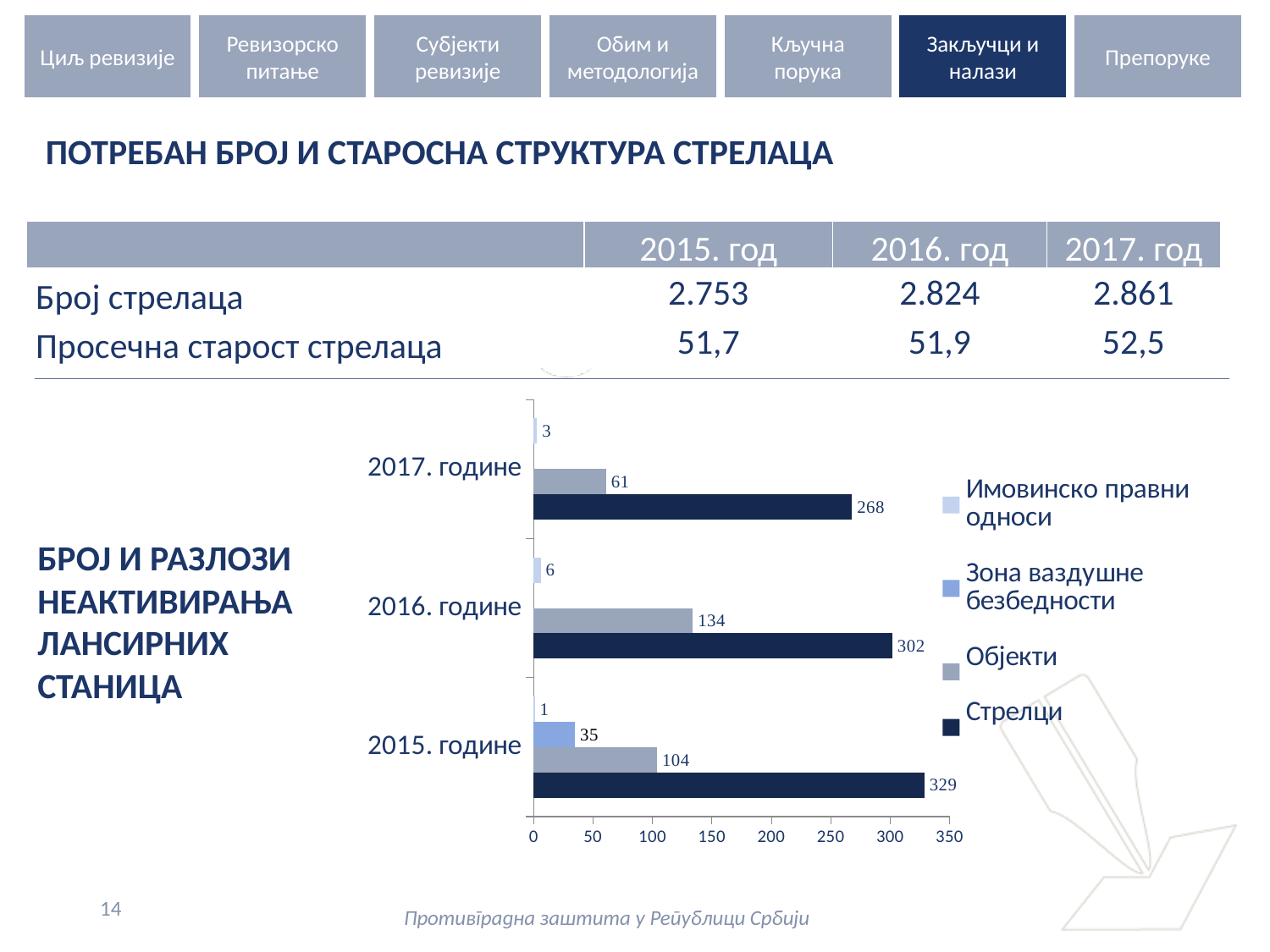
What kind of chart is shown on the slide? bar chart What is the value for Објекти in 2016. године? 134 How many series does the chart legend list? 4 What is the value for Зона ваздушне безбедности in 2015. године? 35 Which is larger: Објекти in 2015. године or Објекти in 2016. године? Објекти in 2016. године Does the value for Стрелци decrease from 2015. године to 2017. године? yes What is the value for Имовинско правни односи in 2017. године? 3 In which year is the value for Објекти the lowest? 2017. године How many year categories are shown on the chart? 3 What is the difference between the Стрелци values for 2016. године and 2017. године? 34 In which year is the value for Стрелци the highest? 2015. године What is the value for Стрелци in 2015. године? 329